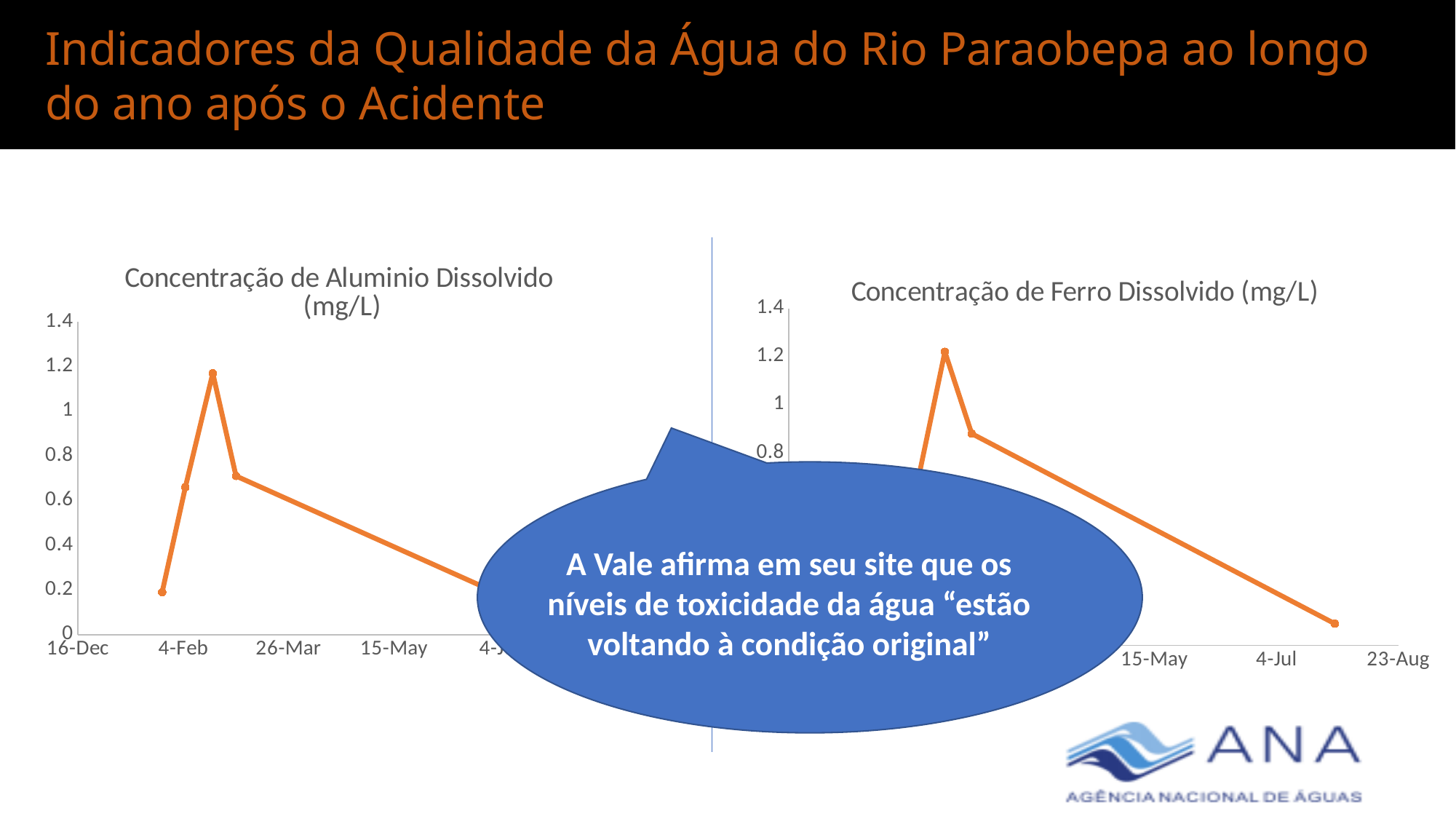
In the 'Concentração de Ferro Dissolvido (mg/L)' chart, do the values rise or fall after the peak as the dates move toward 23-Aug? fall In the 'Concentração de Aluminio Dissolvido (mg/L)' chart, is the value of the point immediately after the peak greater or less than 0.8? less What is the title of the chart on the right side of the slide? Concentração de Ferro Dissolvido (mg/L) What kind of chart is the 'Concentração de Aluminio Dissolvido (mg/L)' chart on the left? line chart In the 'Concentração de Ferro Dissolvido (mg/L)' chart, is the last plotted value (between 4-Jul and 23-Aug) greater or less than 0.2? less In the 'Concentração de Aluminio Dissolvido (mg/L)' chart, is the first plotted value (near 16-Dec/4-Feb) greater or less than 0.4? less In the 'Concentração de Aluminio Dissolvido (mg/L)' chart, which is larger: the peak value or the first plotted value? the peak value What is the highest value shown on the y axis of the 'Concentração de Ferro Dissolvido (mg/L)' chart? 1.4